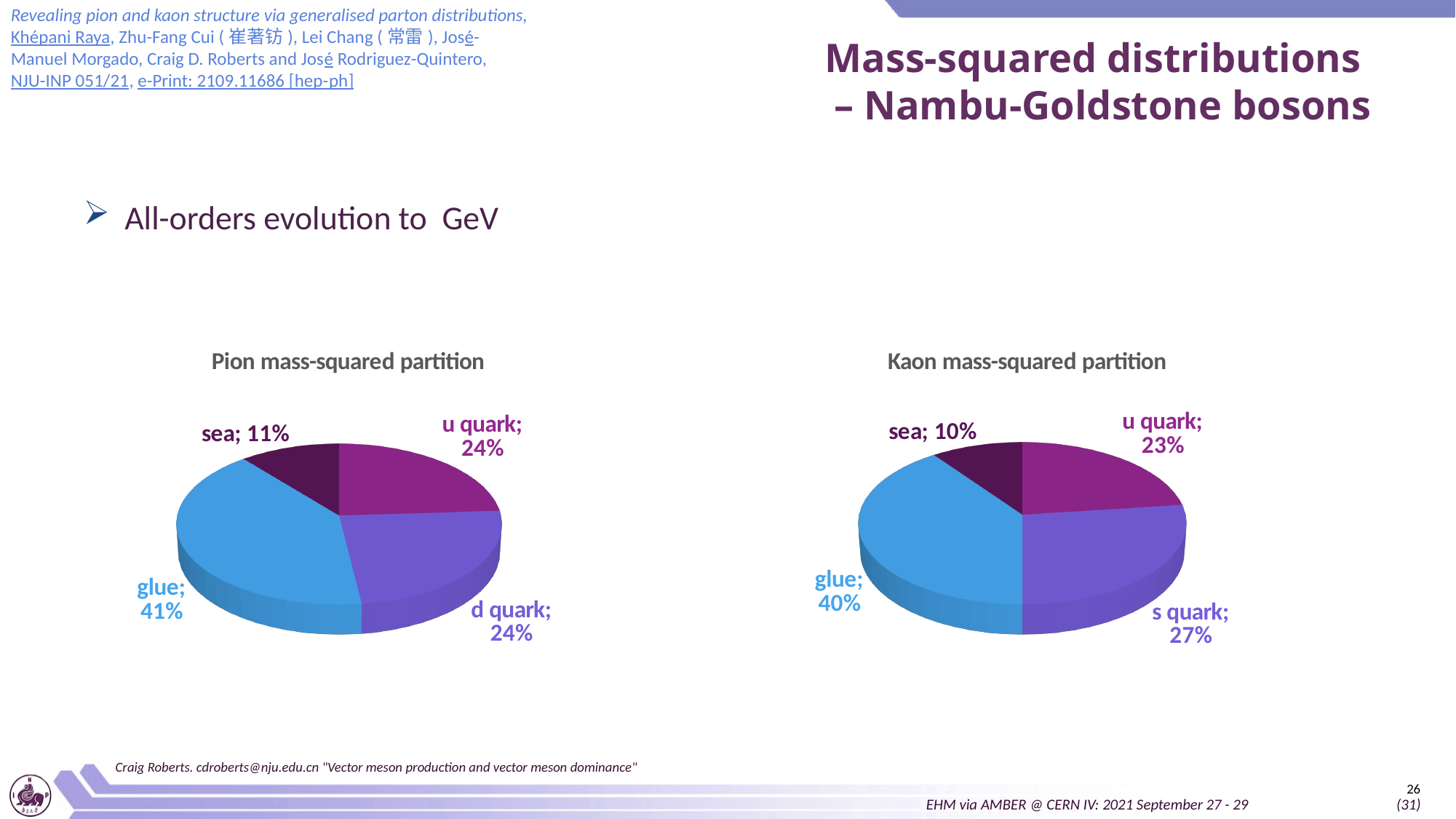
In the 'Kaon mass-squared partition' chart, what share does the s quark have? 27% In the 'Pion mass-squared partition' chart, what share does glue have? 41% In the 'Kaon mass-squared partition' chart, what is the difference between the glue share and the s quark share? 13% In the 'Pion mass-squared partition' chart, what is the difference between the u quark share and the sea share? 13% In the 'Pion mass-squared partition' chart, which category has the largest share? glue In the 'Pion mass-squared partition' chart, what share does sea have? 11% In the 'Kaon mass-squared partition' chart, what share does the u quark have? 23% In the 'Kaon mass-squared partition' chart, which category has the smallest share? sea What kind of chart is the 'Kaon mass-squared partition' chart? pie chart In the 'Pion mass-squared partition' chart, what colour is the glue slice? light blue How many slices does the 'Pion mass-squared partition' chart have? 4 In the 'Kaon mass-squared partition' chart, which is larger, the s quark share or the u quark share? s quark